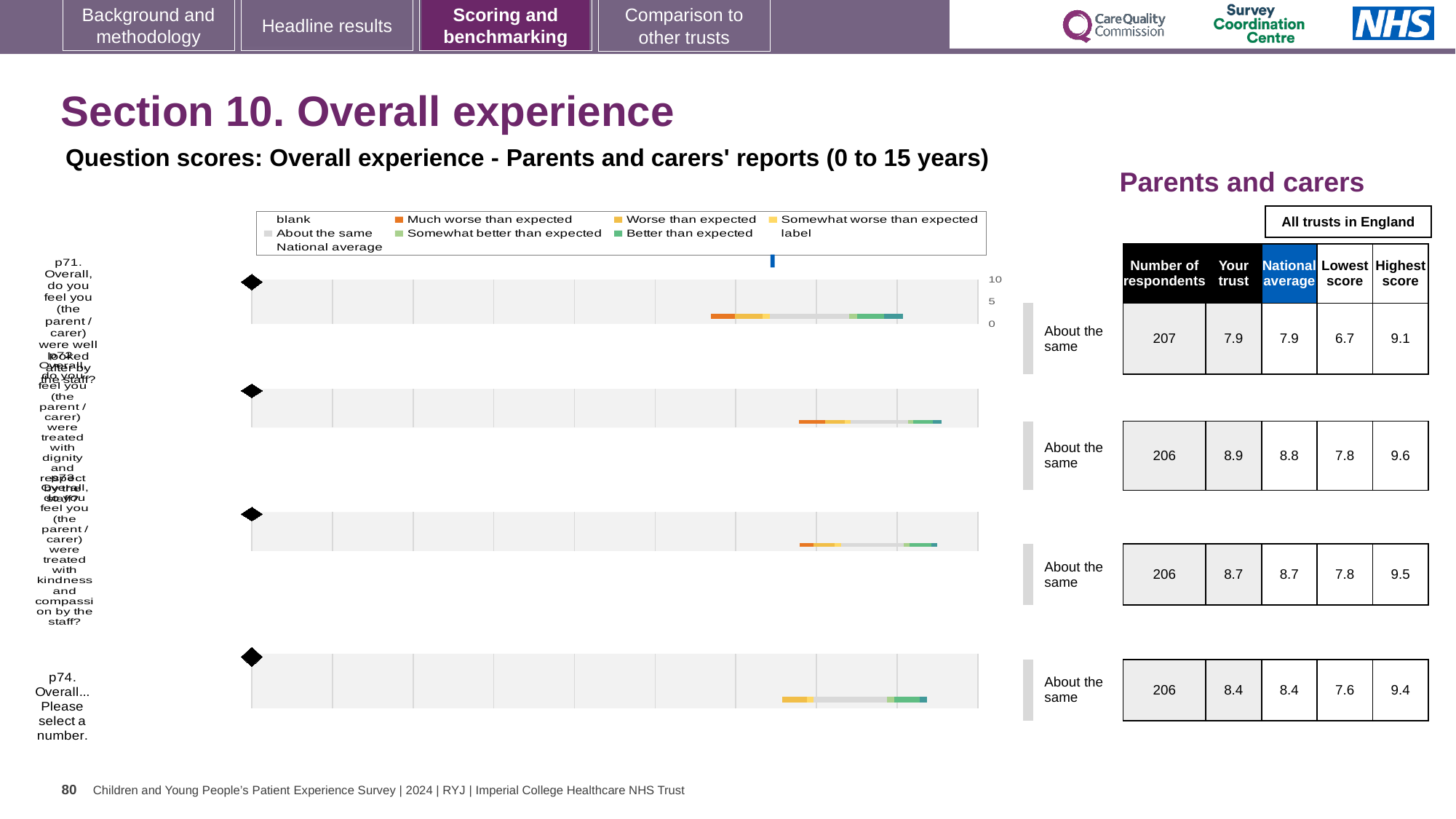
What is the national average for p72? 8.8 Which question has the lowest 'Your trust' score? p71 Which legend entry is shown in orange? Much worse than expected Which question has the highest 'Your trust' score? p72 What is the 'Your trust' score for p74 (Overall... Please select a number)? 8.4 How many survey questions (categories) are plotted in the chart? 4 Is the 'Your trust' score for p72 greater or less than the 'Your trust' score for p73? greater How many entries does the chart legend list? 9 What kind of chart is shown on the slide? bar chart What is the difference between the highest score and the lowest score for p71? 2.4 What is the highest tick value shown on the chart's axis? 10 What is the 'Your trust' score for p71? 7.9